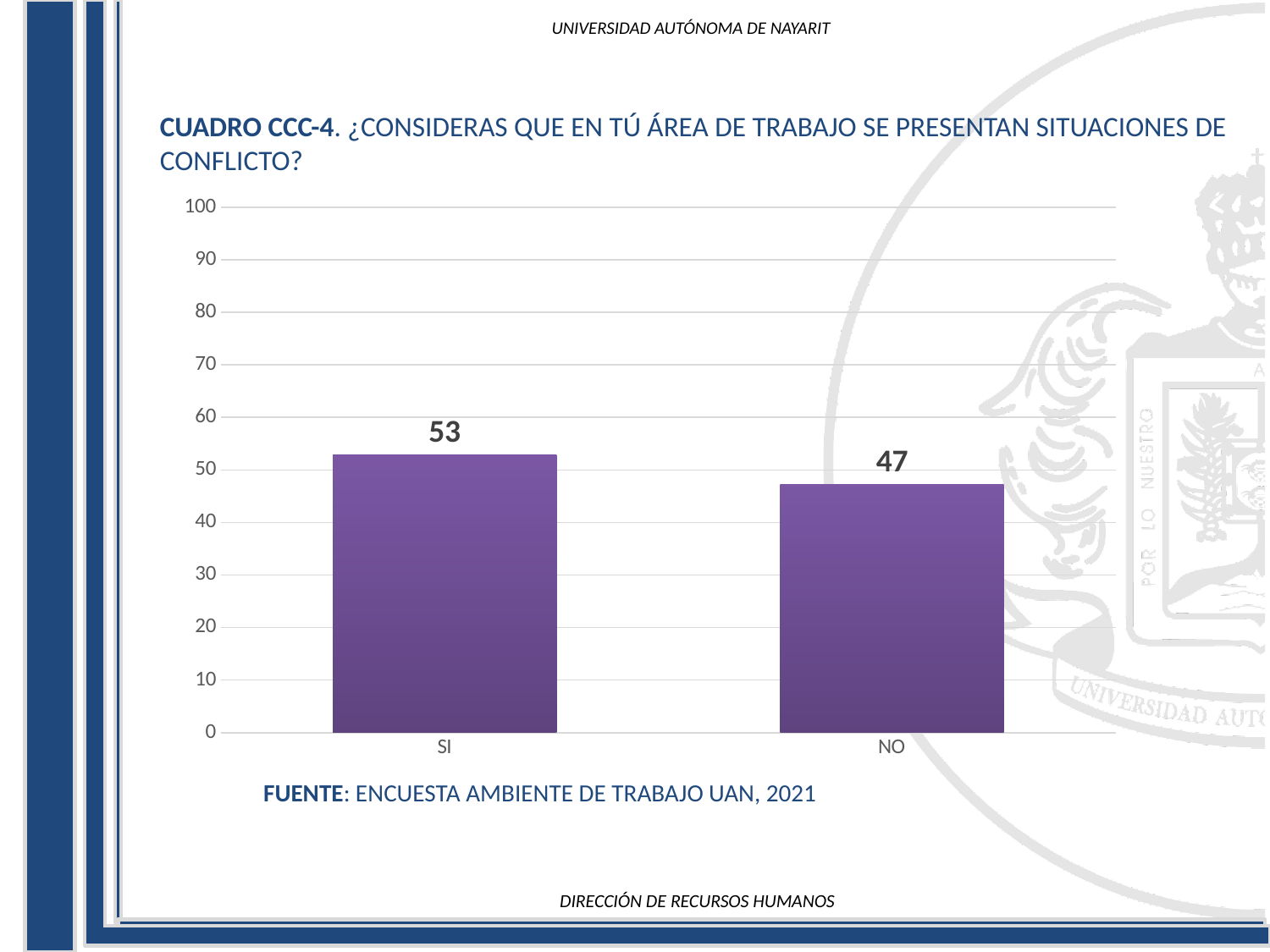
Which is larger, the value for SI or the value for NO? SI How many categories are shown on the x axis? 2 What is the value for SI? 53 Is the value for SI greater or less than 50? greater What kind of chart is shown on the slide? bar chart Which category has the highest value? SI What is the total of the two bars? 100 What is the source cited below the chart? ENCUESTA AMBIENTE DE TRABAJO UAN, 2021 What is the difference between the values for SI and NO? 6 Is the value for NO greater or less than 50? less What is the value for NO? 47 Which category has the lowest value? NO